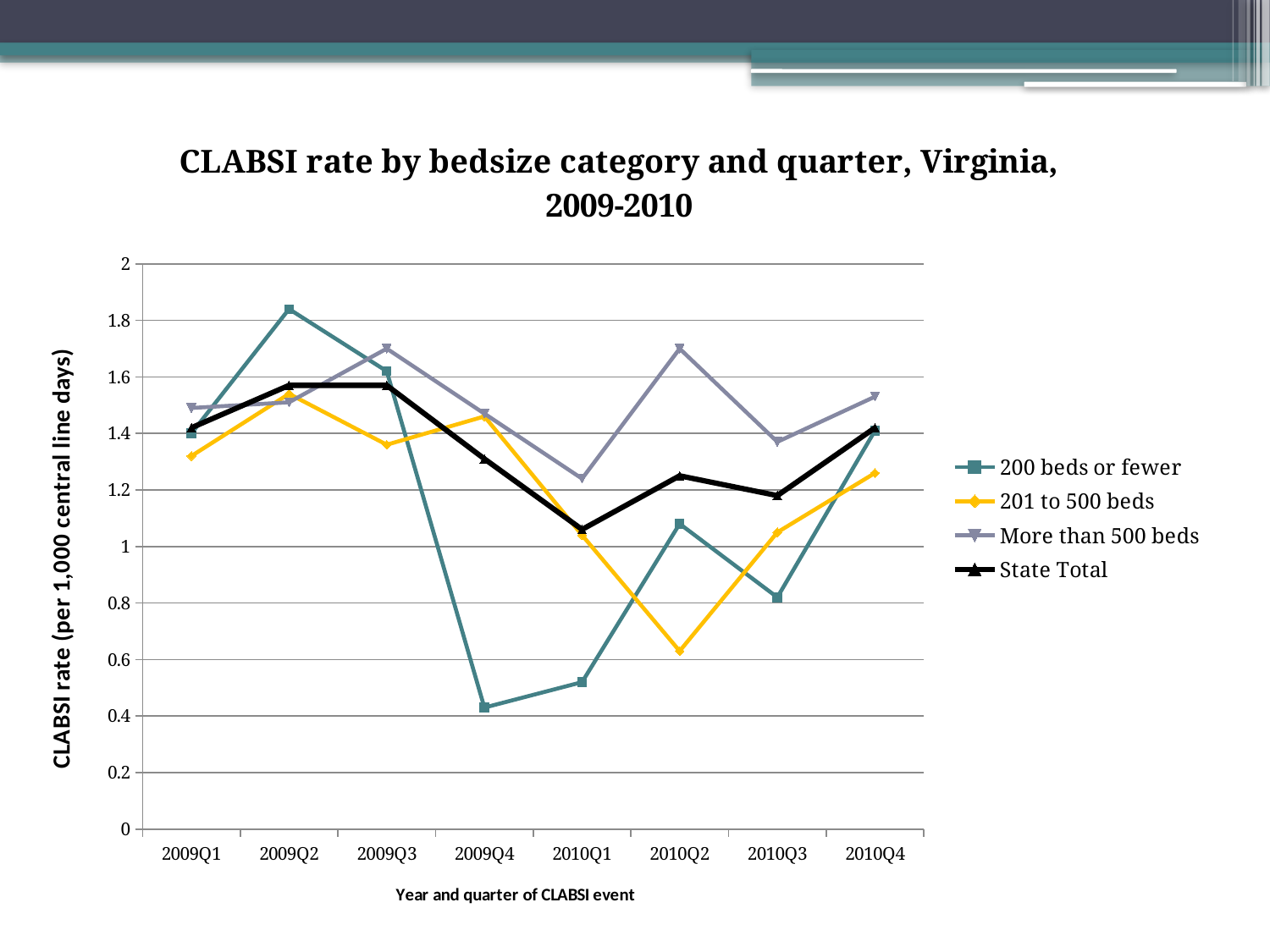
How many quarters are plotted along the x axis? 8 Does the State Total CLABSI rate rise or fall from 2009Q3 to 2010Q1? Fall Is the value for 200 beds or fewer in 2009Q4 greater or less than 0.6? less How many series does the legend list? 4 In which quarter is the CLABSI rate for 200 beds or fewer lowest? 2009Q4 What kind of chart is shown on the slide? Line chart What is the title of the y axis? CLABSI rate (per 1,000 central line days) Is the value for More than 500 beds in 2010Q2 greater or less than 1.6? greater In which quarter is the CLABSI rate for 200 beds or fewer highest? 2009Q2 In which quarter is the CLABSI rate for 201 to 500 beds lowest? 2010Q2 In which quarter is the State Total CLABSI rate lowest? 2010Q1 In 2010Q2, which series has the higher CLABSI rate: 200 beds or fewer, or 201 to 500 beds? 200 beds or fewer